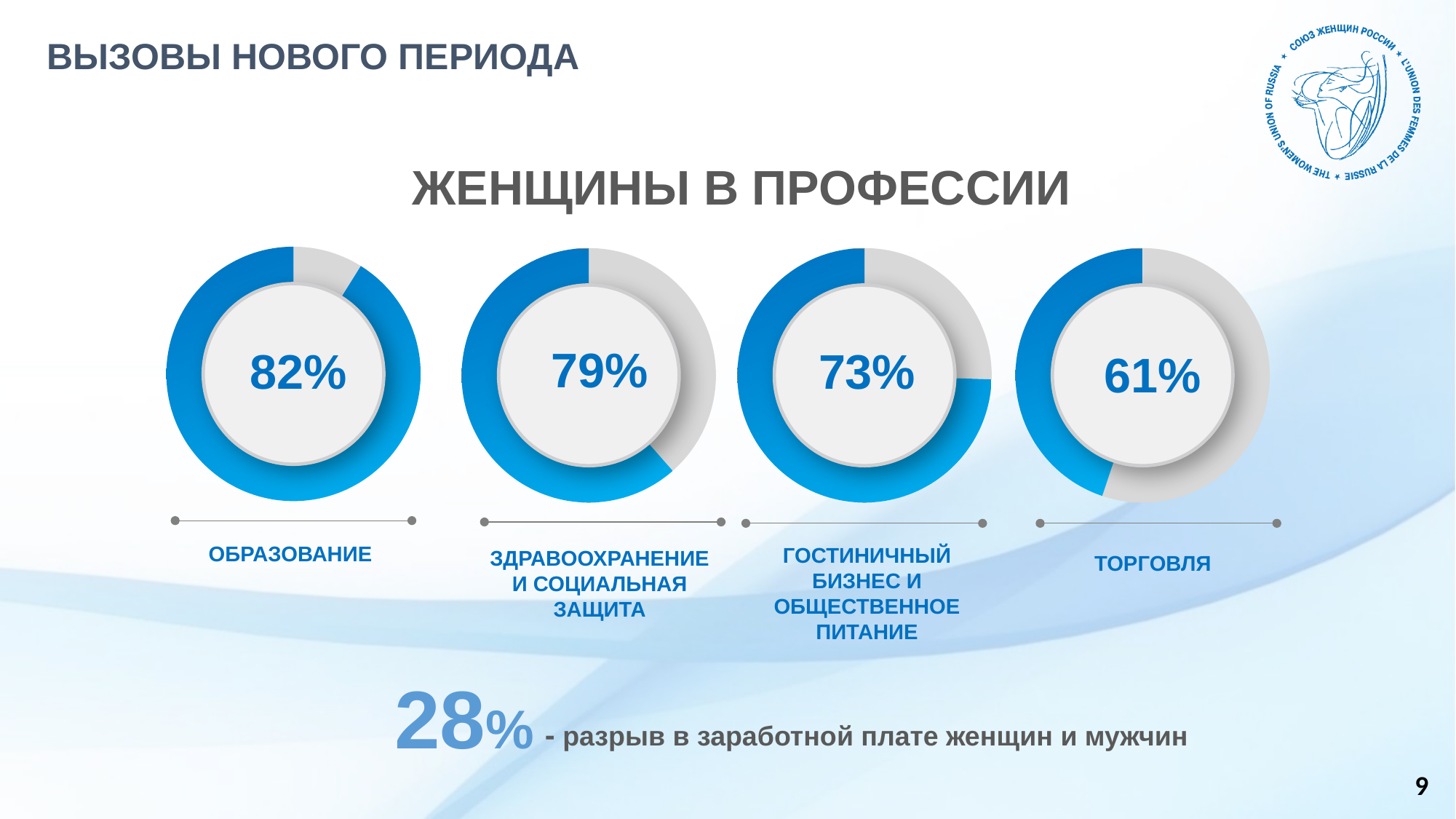
What is the value shown in the donut chart for ЗДРАВООХРАНЕНИЕ И СОЦИАЛЬНАЯ ЗАЩИТА? 79% What is the title above the four donut charts? ЖЕНЩИНЫ В ПРОФЕССИИ What is the value shown in the donut chart for ОБРАЗОВАНИЕ? 82% What is the difference between the values for ЗДРАВООХРАНЕНИЕ И СОЦИАЛЬНАЯ ЗАЩИТА and ГОСТИНИЧНЫЙ БИЗНЕС И ОБЩЕСТВЕННОЕ ПИТАНИЕ? 6% What is the difference between the values for ОБРАЗОВАНИЕ and ТОРГОВЛЯ? 21% Which sector has the highest percentage among the four donut charts? ОБРАЗОВАНИЕ What is the value shown in the donut chart for ТОРГОВЛЯ? 61% Which is larger: the value for ЗДРАВООХРАНЕНИЕ И СОЦИАЛЬНАЯ ЗАЩИТА or the value for ТОРГОВЛЯ? ЗДРАВООХРАНЕНИЕ И СОЦИАЛЬНАЯ ЗАЩИТА Which sector has the lowest percentage among the four donut charts? ТОРГОВЛЯ How many donut charts are shown on the slide? 4 What kind of chart is used to show the percentages for each sector? Donut chart What is the value shown in the donut chart for ГОСТИНИЧНЫЙ БИЗНЕС И ОБЩЕСТВЕННОЕ ПИТАНИЕ? 73%